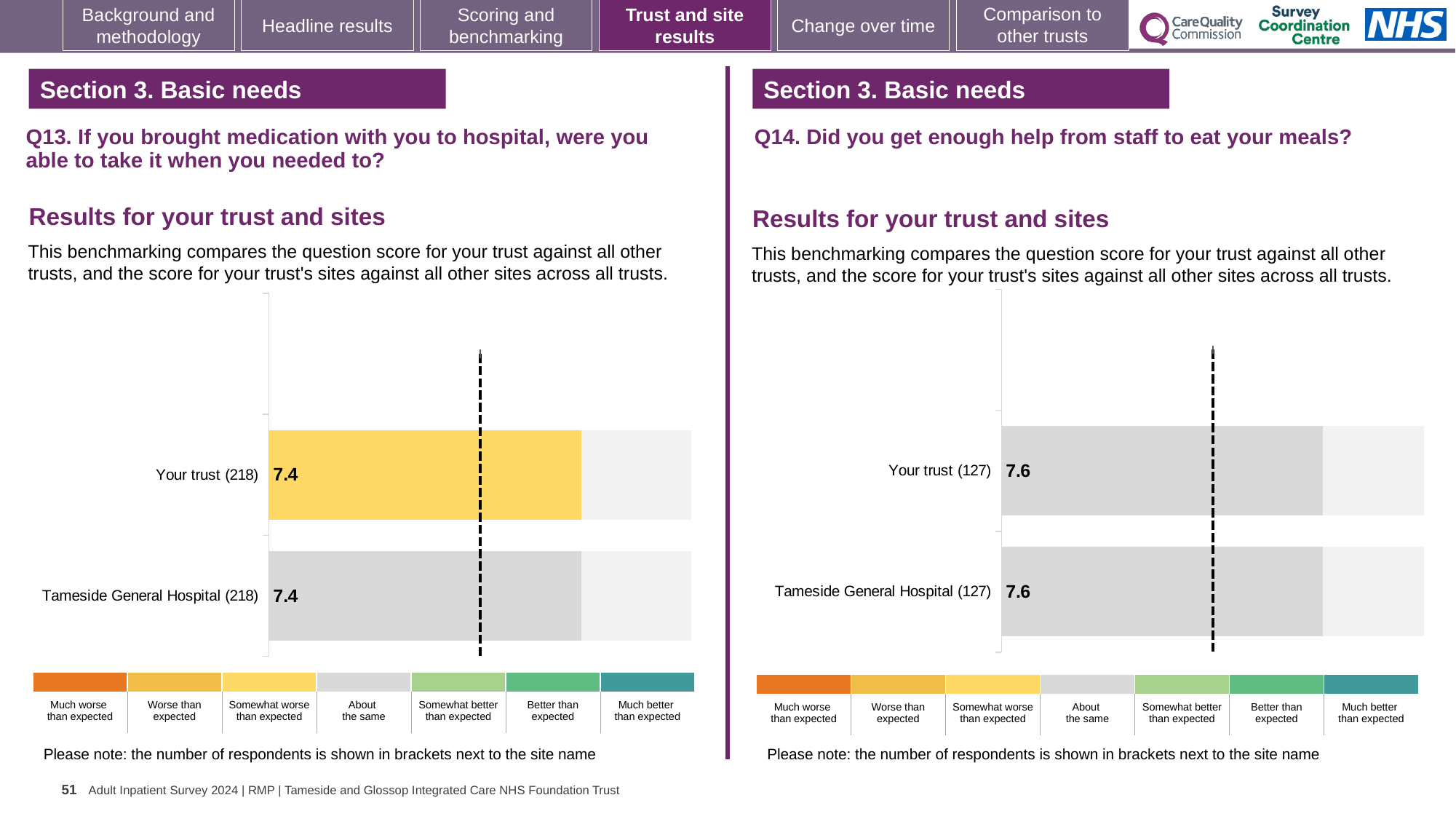
In the Q13 chart on the left, how many respondents are shown in brackets next to Your trust? 218 In the Q13 chart on the left, what is the score for Your trust? 7.4 In the Q13 chart on the left, what is the score for Tameside General Hospital? 7.4 In the Q14 chart on the right, what is the score for Your trust? 7.6 In the Q14 chart on the right, how many respondents are shown in brackets next to Tameside General Hospital? 127 How many bars are plotted in the Q13 chart on the left? 2 In the Q14 chart on the right, what is the score for Tameside General Hospital? 7.6 Is the Your trust score in the Q14 chart on the right larger or smaller than the Your trust score in the Q13 chart on the left? Larger In the Q13 chart on the left, what is the difference between the Your trust score and the Tameside General Hospital score? 0 What type of chart is used for the Q13 results on the left? Bar chart In the Q14 chart on the right, what is the difference between the Your trust score and the Tameside General Hospital score? 0 How many bars are plotted in the Q14 chart on the right? 2